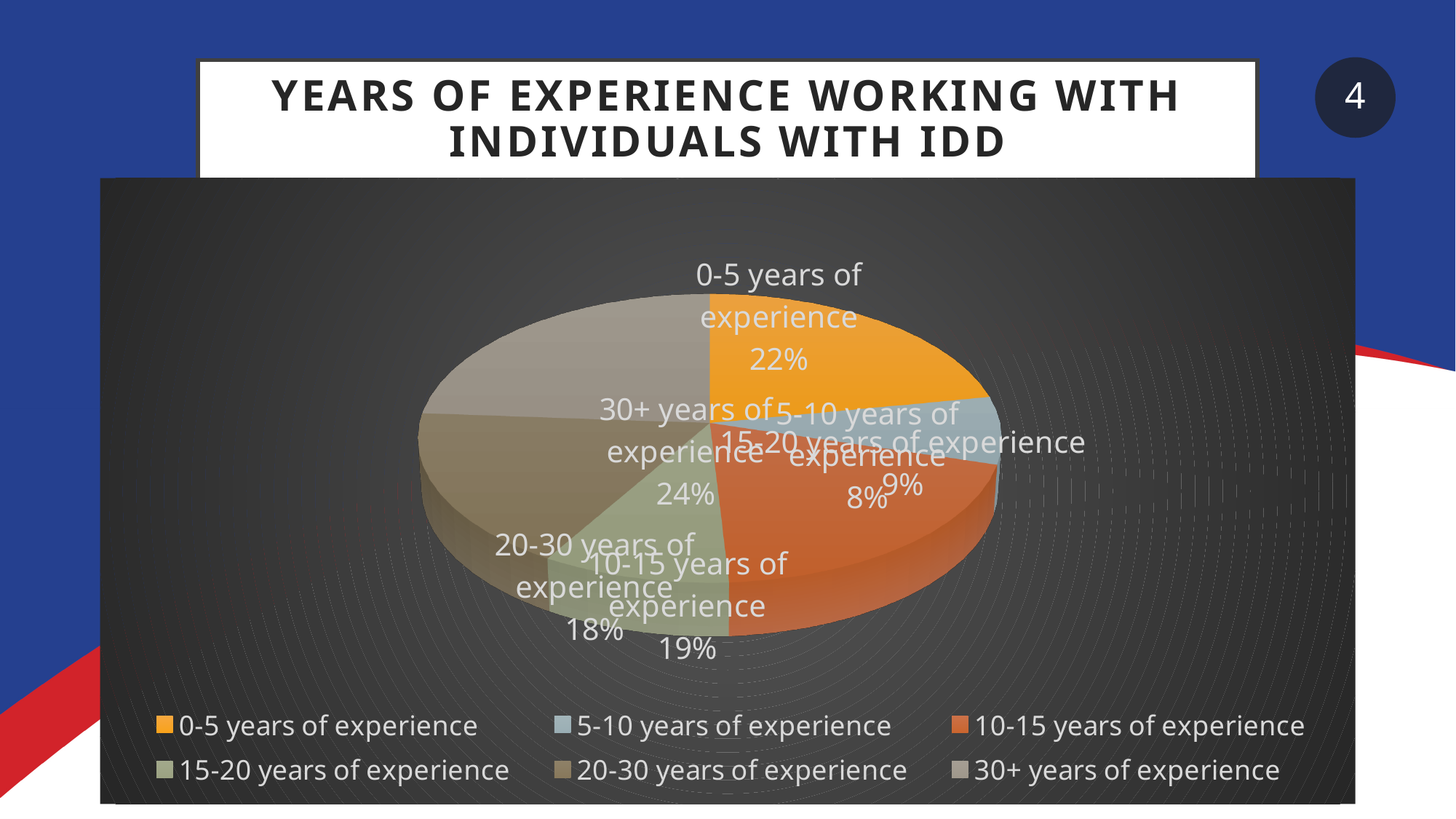
What is the title of the slide containing the pie chart? Years of Experience Working with Individuals with IDD What share of the pie does the 0-5 years of experience slice represent? 22% What percentage is shown for 30+ years of experience? 24% Which is larger: the share for 20-30 years of experience or the share for 30+ years of experience? 30+ years of experience What is the difference in percentage points between the 30+ years of experience slice and the 0-5 years of experience slice? 2 percentage points What kind of chart is shown on the slide? Pie chart What percentage is shown for 10-15 years of experience? 19% Which is larger: the share for 0-5 years of experience or the share for 10-15 years of experience? 0-5 years of experience How many experience categories are shown in the pie chart? 6 Which experience category has the largest share of the pie? 30+ years of experience What percentage is shown for 20-30 years of experience? 18% How many entries does the legend list? 6